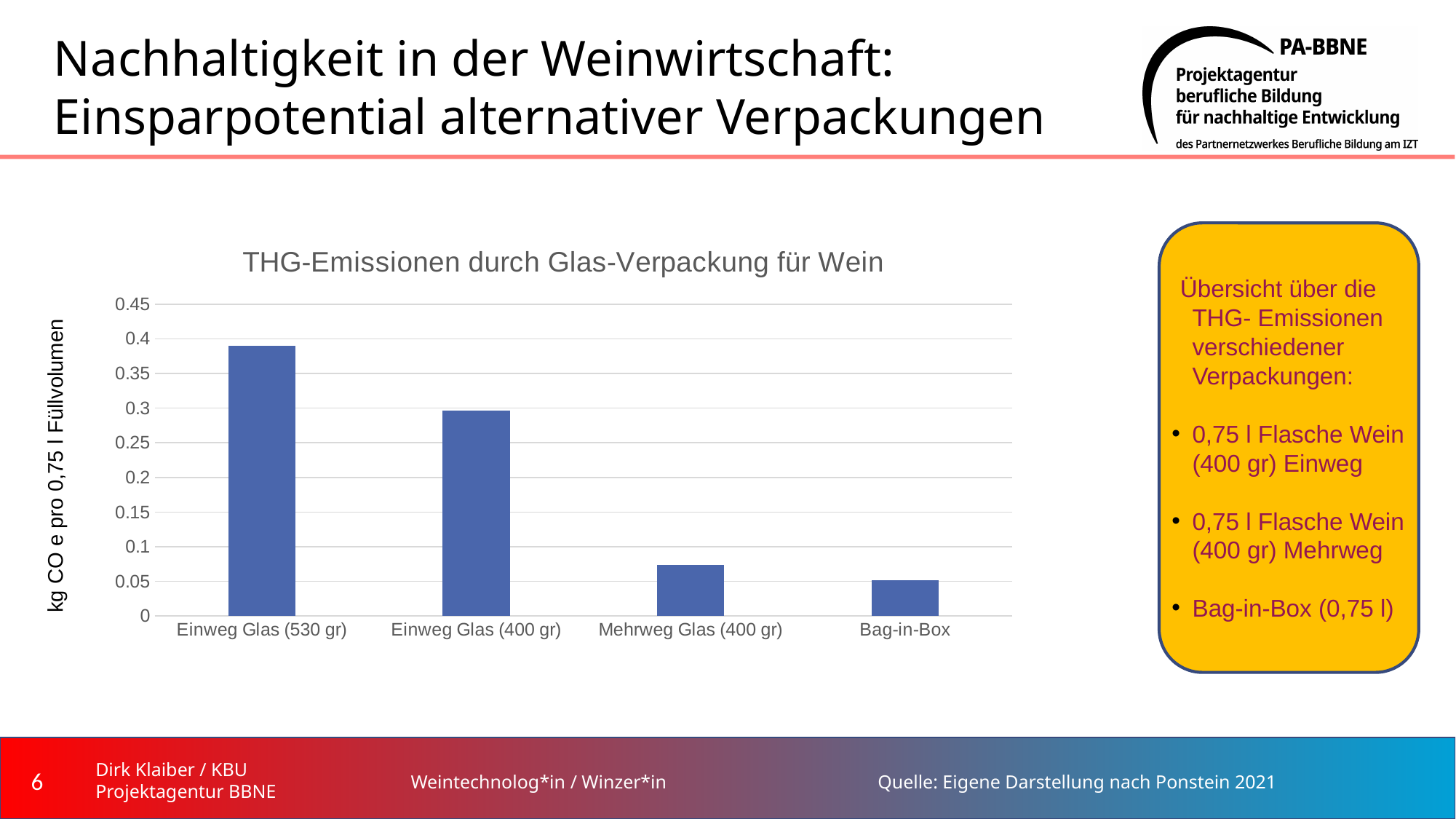
Which category has the lowest value in the chart? Bag-in-Box What is the title of the chart? THG-Emissionen durch Glas-Verpackung für Wein Which is larger, the value for Mehrweg Glas (400 gr) or Bag-in-Box? Mehrweg Glas (400 gr) What kind of chart is shown on the slide? bar chart Is the value for Bag-in-Box greater or less than 0.1? less Is the value for Einweg Glas (530 gr) greater or less than 0.35? greater Do the values rise or fall from left to right along the x axis? fall Which is larger, the value for Einweg Glas (530 gr) or Einweg Glas (400 gr)? Einweg Glas (530 gr) Is the value for Einweg Glas (400 gr) greater or less than 0.25? greater Which category has the highest value in the chart? Einweg Glas (530 gr) How many categories are shown on the x axis of the chart? 4